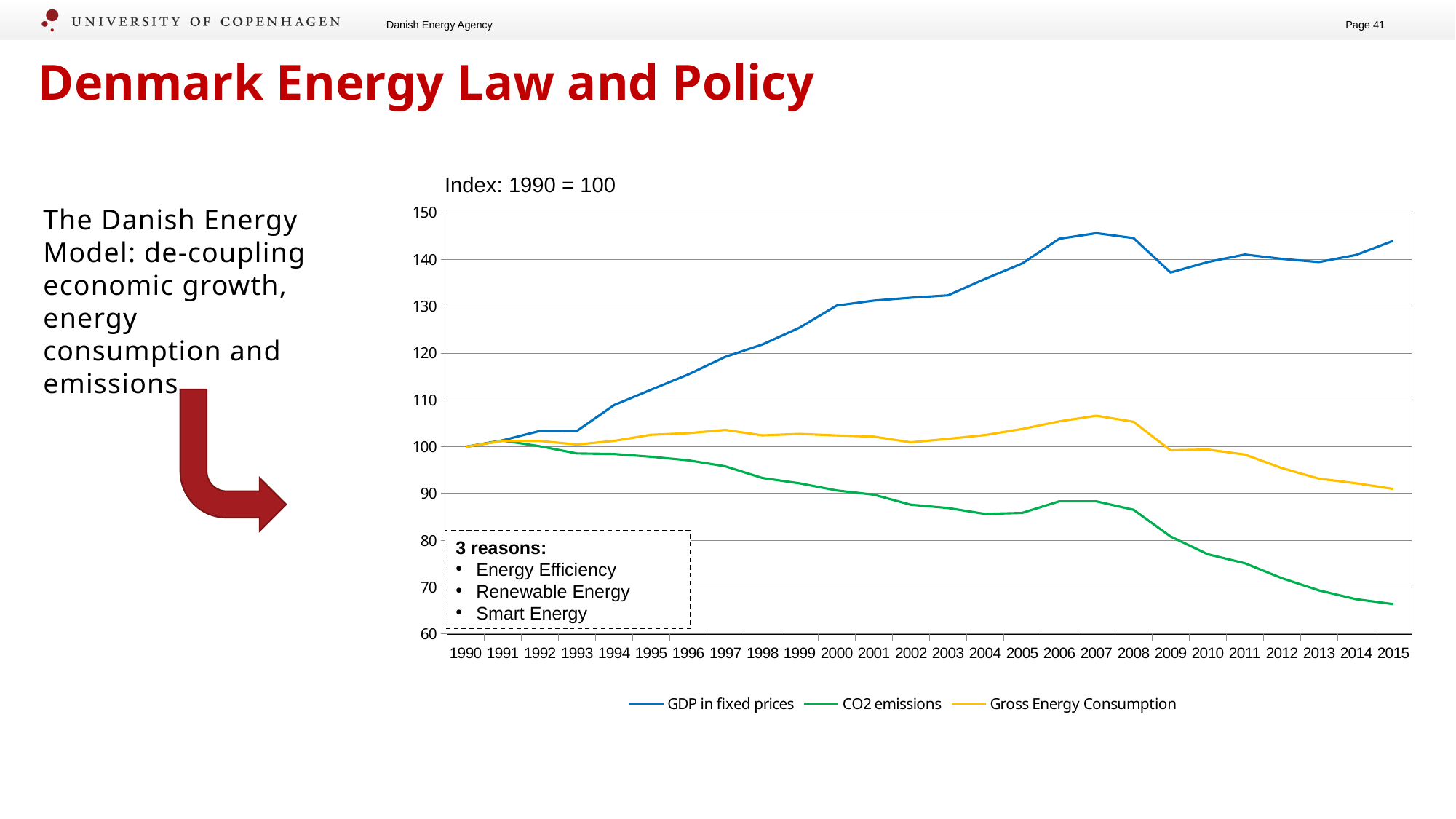
What is the index value of all three series in 1990? 100 Is the value for Gross Energy Consumption in 2015 greater or less than 100? less How many years are shown along the x axis of the chart? 26 How many series does the chart legend list? 3 Which series has the highest value in 2015? GDP in fixed prices What is the title shown above the chart? Index: 1990 = 100 Is the value for GDP in fixed prices in 2015 greater or less than 140? greater Which series has the lowest value in 2015? CO2 emissions What kind of chart is shown on the slide? line chart Is the value for CO2 emissions in 2015 greater or less than 70? less Does the CO2 emissions series generally rise or fall from 1990 to 2015? fall Does the GDP in fixed prices series generally rise or fall from 1990 to 2015? rise